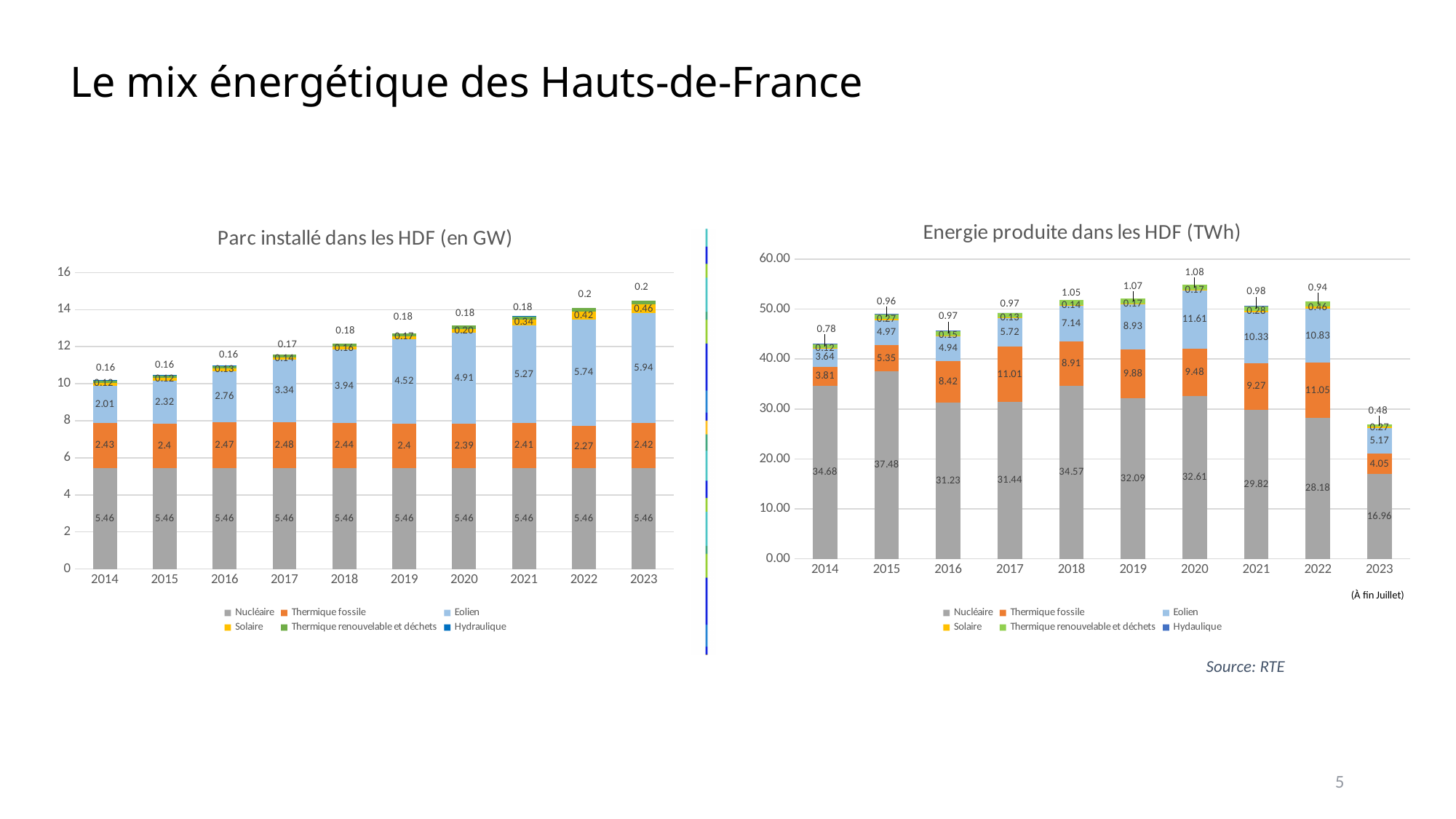
In the chart 'Parc installé dans les HDF (en GW)', which year has the highest Eolien value? 2023 In the chart 'Energie produite dans les HDF (TWh)', what is the Thermique fossile value for 2022? 11.05 In the chart 'Energie produite dans les HDF (TWh)', what is the Nucléaire value for 2015? 37.48 In the chart 'Energie produite dans les HDF (TWh)', what is the difference between the Nucléaire values for 2015 and 2023? 20.52 In the chart 'Parc installé dans les HDF (en GW)', what is the difference between the Eolien values for 2023 and 2014? 3.93 How many years are shown on the x axis of the chart 'Parc installé dans les HDF (en GW)'? 10 In the chart 'Energie produite dans les HDF (TWh)', which is larger: the Eolien value for 2020 or for 2022? 2020 In the chart 'Energie produite dans les HDF (TWh)', which year has the lowest Nucléaire value? 2023 In the chart 'Parc installé dans les HDF (en GW)', what is the Nucléaire value for 2018? 5.46 In the chart 'Parc installé dans les HDF (en GW)', does the Eolien value rise or fall from 2014 to 2023? rise How many series does the legend of the chart 'Energie produite dans les HDF (TWh)' list? 6 In the chart 'Parc installé dans les HDF (en GW)', what is the Eolien value for 2023? 5.94